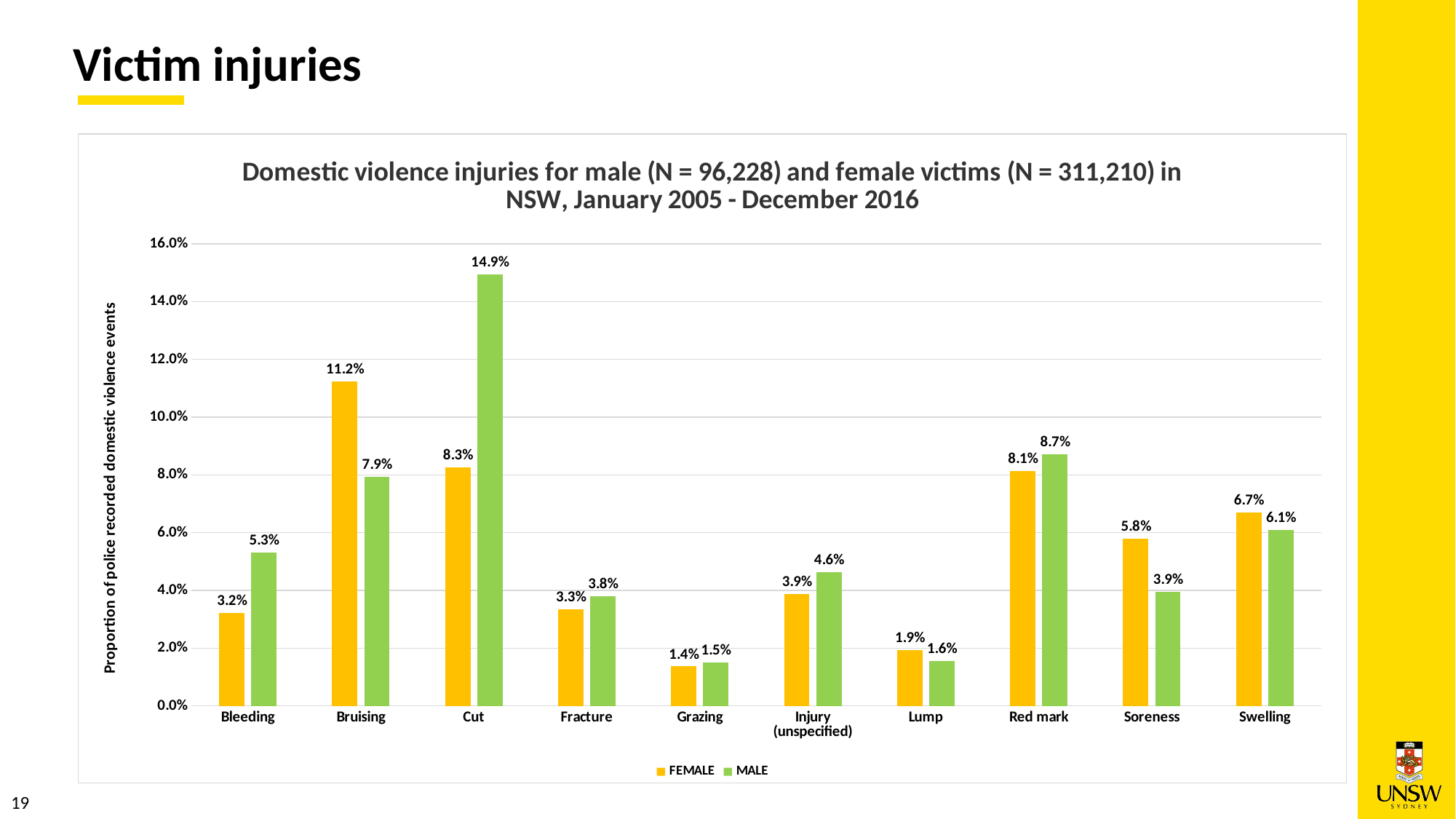
Which injury category has the lowest FEMALE value? Grazing What is the difference between the FEMALE and MALE values for Soreness? 1.9% Which is larger for Bruising, the FEMALE value or the MALE value? FEMALE What kind of chart is shown on the slide? Bar chart What is the difference between the MALE and FEMALE values for Cut? 6.6% Which injury category has the highest MALE value? Cut What is the FEMALE value for Soreness? 5.8% What is the label of the y axis? Proportion of police recorded domestic violence events What is the FEMALE value for Bruising? 11.2% How many injury categories are shown on the x axis? 10 What is the MALE value for Cut? 14.9% How many series does the legend list? 2